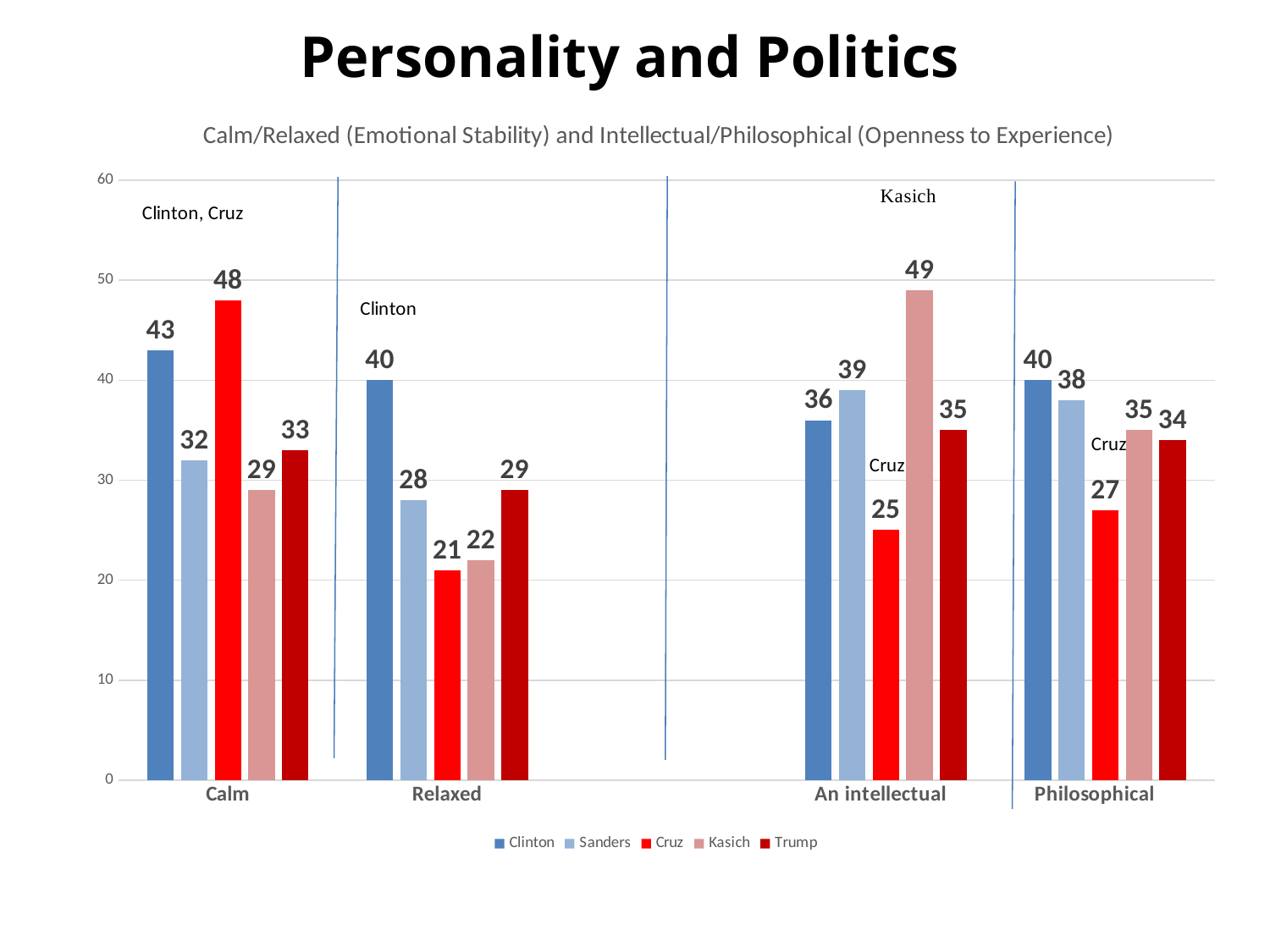
Which is larger in the Calm category: Sanders or Trump? Trump What is the value for Kasich in the An intellectual category? 49 What kind of chart is shown on the slide? Bar chart Is the value for Kasich in the Relaxed category greater or less than 30? less How many series does the legend list? 5 Which candidate has the lowest value in the An intellectual category? Cruz Which candidate has the highest value in the Relaxed category? Clinton What is the difference between Clinton's and Cruz's values in the Philosophical category? 13 What is the chart's title? Calm/Relaxed (Emotional Stability) and Intellectual/Philosophical (Openness to Experience) How many categories are shown on the x axis? 4 What is the value for Sanders in the Relaxed category? 28 What is the value for Cruz in the Calm category? 48